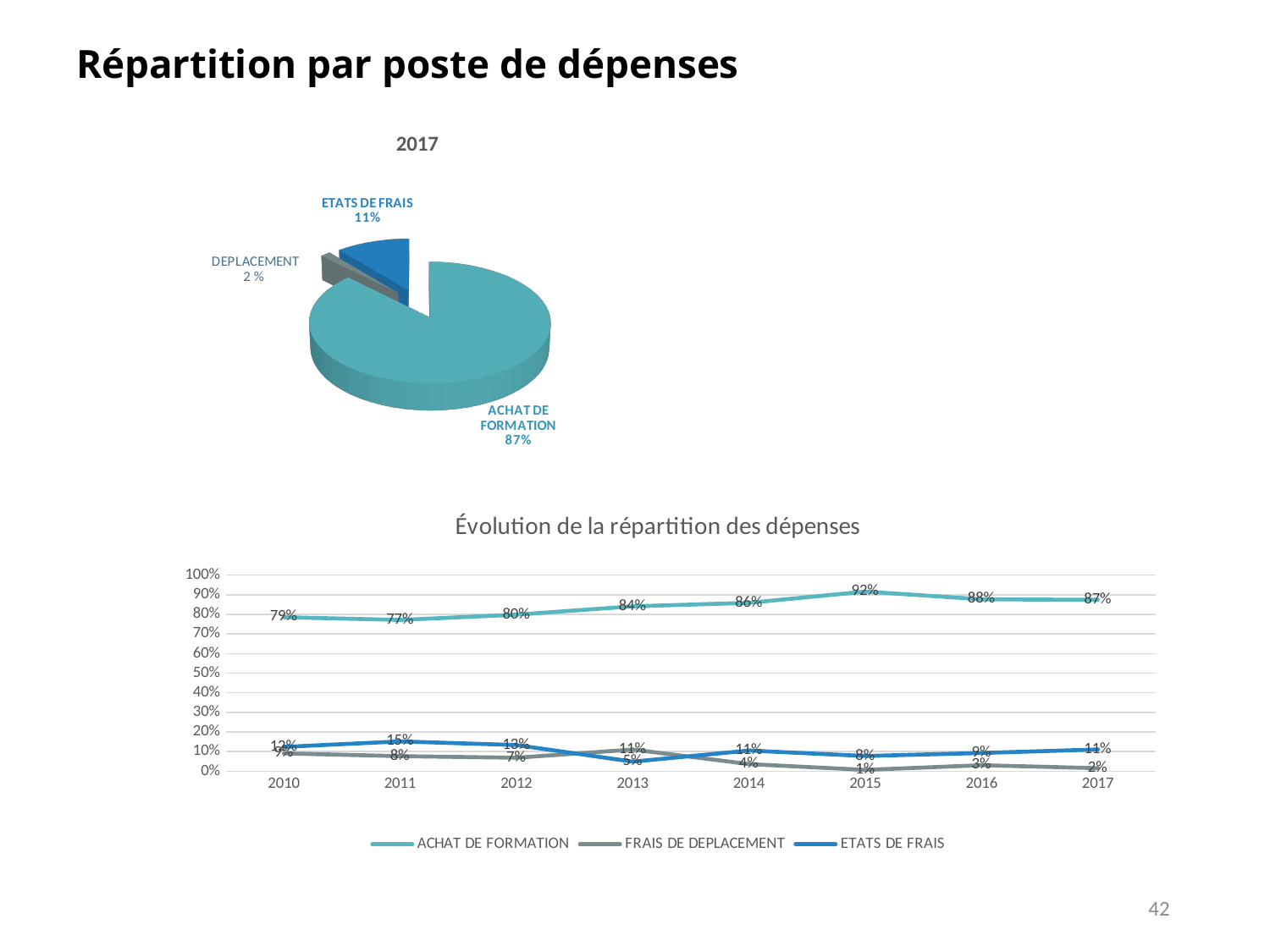
In the chart 'Évolution de la répartition des dépenses', what is the value of ETATS DE FRAIS in 2011? 15% In the pie chart titled 2017, which category has the largest slice? ACHAT DE FORMATION What kind of chart is 'Évolution de la répartition des dépenses'? Line chart In the chart 'Évolution de la répartition des dépenses', what is the difference between ACHAT DE FORMATION in 2015 and in 2011? 15 percentage points In the pie chart titled 2017, what share does ACHAT DE FORMATION represent? 87% In the chart 'Évolution de la répartition des dépenses', how many years are shown on the x axis? 8 In the chart 'Évolution de la répartition des dépenses', what is the value of FRAIS DE DEPLACEMENT in 2015? 1% In the chart 'Évolution de la répartition des dépenses', in which year is ACHAT DE FORMATION lowest? 2011 In the chart 'Évolution de la répartition des dépenses', what is the value of ACHAT DE FORMATION in 2015? 92% In the chart 'Évolution de la répartition des dépenses', how many series does the legend list? 3 In the pie chart titled 2017, what share does ETATS DE FRAIS represent? 11% In the pie chart titled 2017, how many slices are there? 3